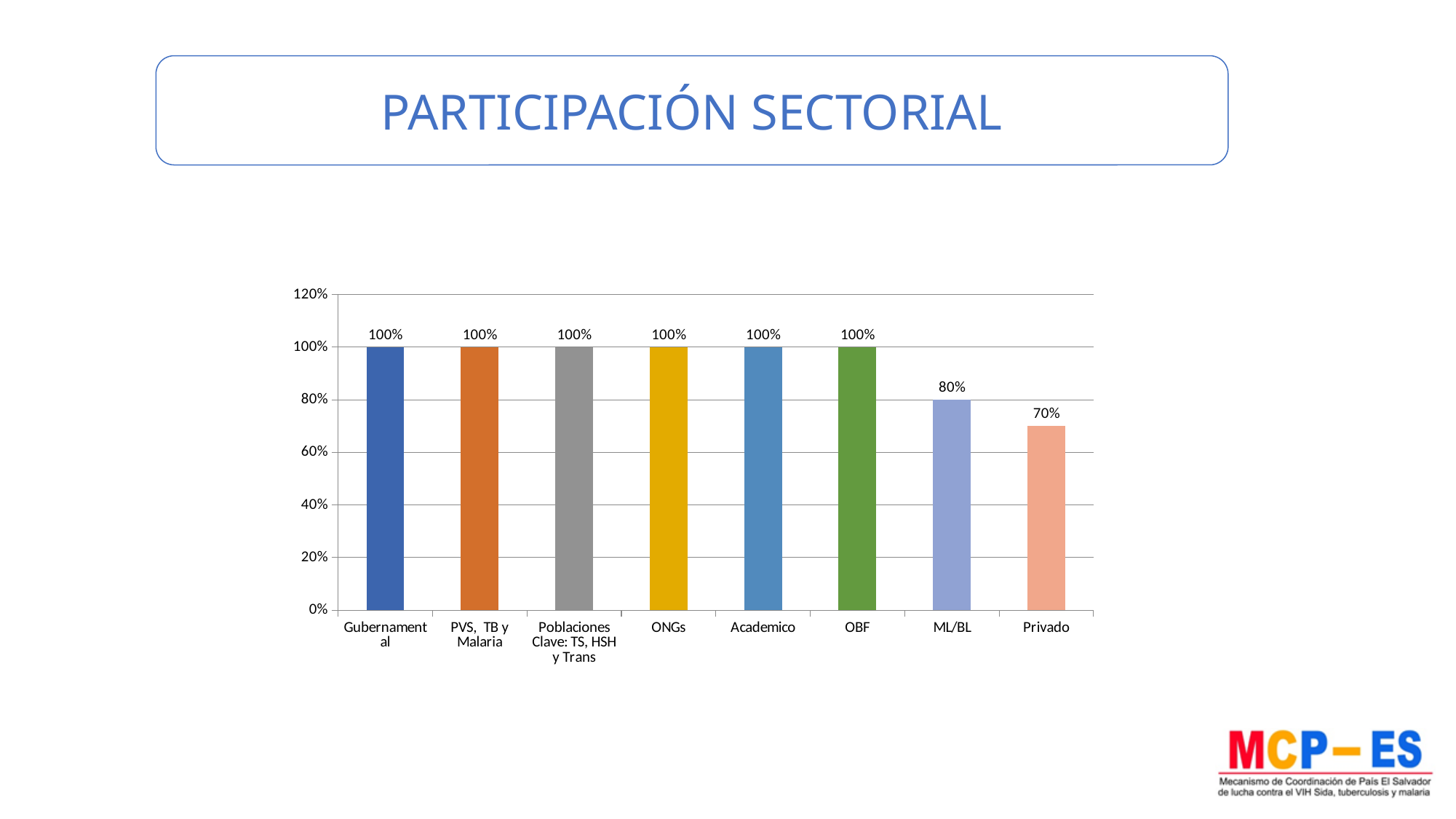
Which category has the lowest value? Privado What is the difference between the values for ML/BL and Privado? 10% What is the value for ML/BL? 80% What kind of chart is shown on the slide? bar chart Which is larger, the value for ML/BL or the value for Privado? ML/BL What is the value for ONGs? 100% What is the title of the slide? PARTICIPACIÓN SECTORIAL What is the difference between the values for OBF and ML/BL? 20% What is the value for Privado? 70% What is the value for Academico? 100% Is the value for Privado greater or less than 80%? less How many categories are shown on the x axis? 8